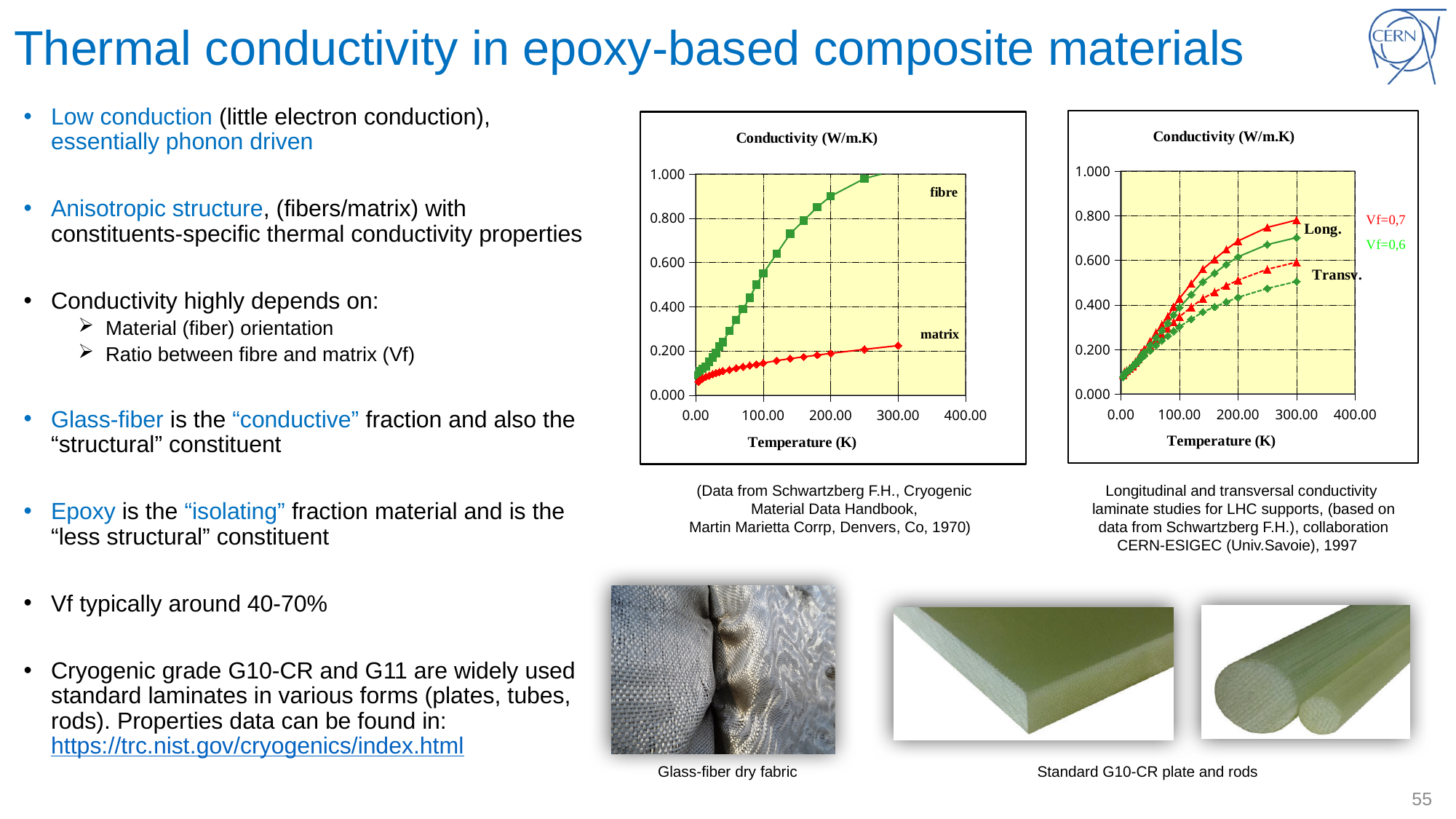
In the right chart, which is higher at 300 K, the Long. or the Transv. conductivity? Long. In the left chart, is the conductivity of the matrix at 300 K greater or less than 0.400? less In the left chart, which series has the higher conductivity at 200 K, fibre or matrix? fibre In the left chart, how does the fibre conductivity change as temperature increases? It rises In the left chart, is the conductivity of the fibre at 200 K greater or less than 0.800? greater What is the x-axis label of the right chart? Temperature (K) How many series are labelled in the left chart? 2 In the left chart, is the conductivity of the fibre at 100 K greater or less than 0.400? greater In the right chart, does the conductivity rise or fall as temperature increases? rises What kind of chart is the left chart? line chart